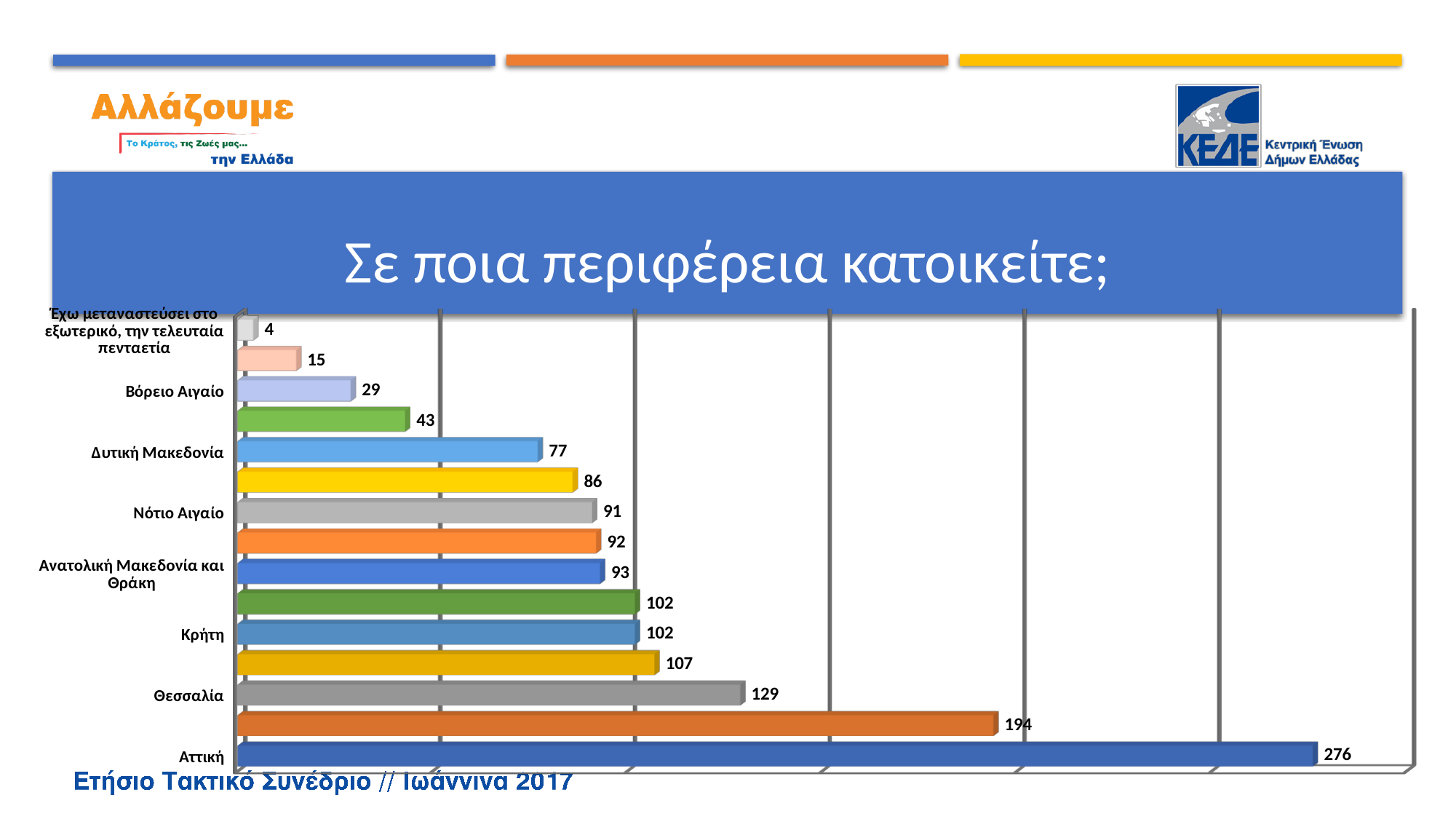
What kind of chart is shown on the slide? bar chart What is the value for Ανατολική Μακεδονία και Θράκη? 93 What is the title of the chart? Σε ποια περιφέρεια κατοικείτε; Which category has the highest value? Αττική Which is larger, the value for Κρήτη or the value for Νότιο Αιγαίο? Κρήτη What is the value for Βόρειο Αιγαίο? 29 Which category has the lowest value? Έχω μεταναστεύσει στο εξωτερικό, την τελευταία πενταετία What is the value for Κρήτη? 102 What is the difference between the values for Αττική and Θεσσαλία? 147 What is the value for Αττική? 276 What is the value for Θεσσαλία? 129 How many bars are plotted in the chart? 15